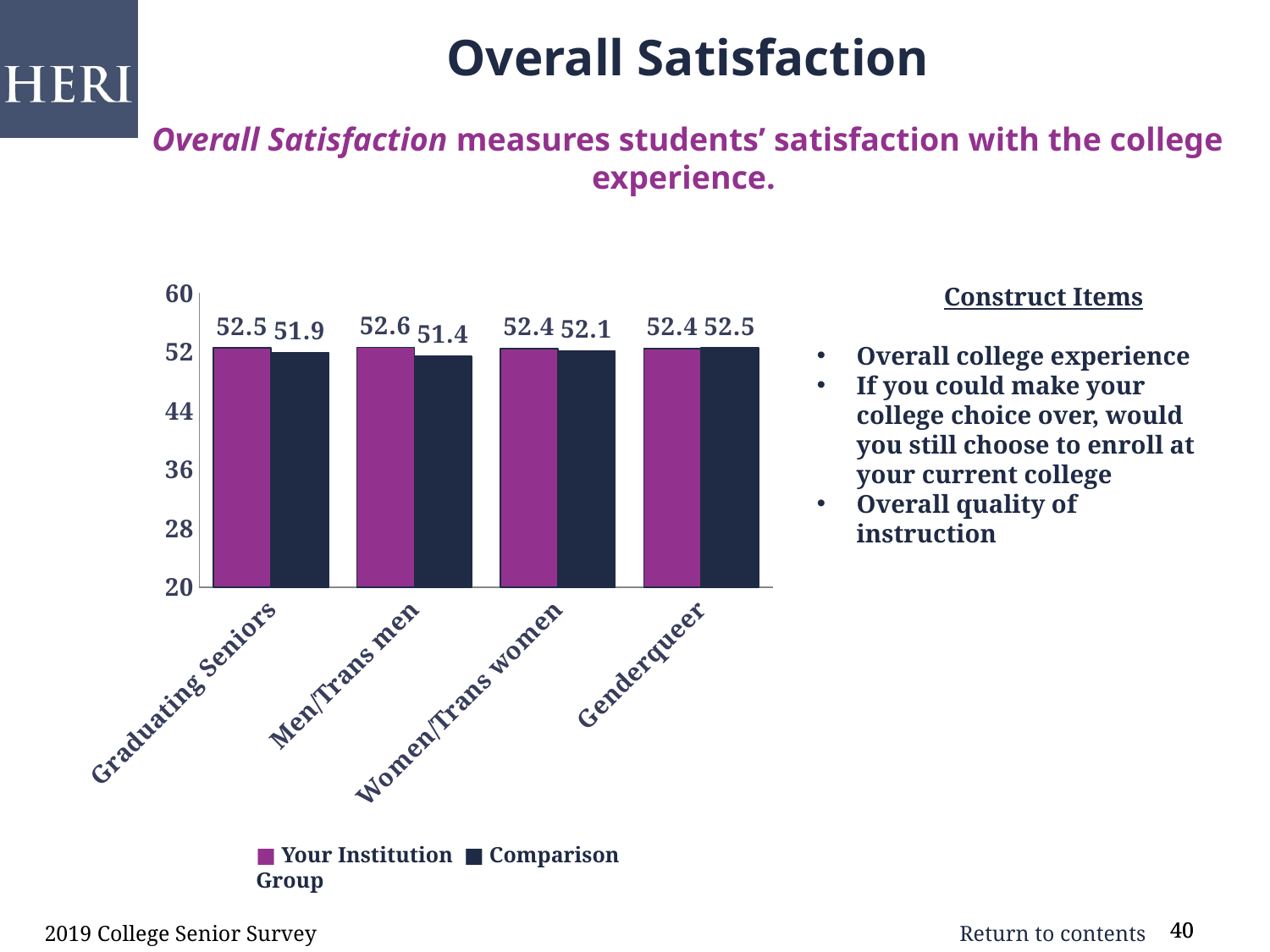
How many series does the legend list? 2 How many categories are shown on the x axis? 4 Which series is shown in purple? Your Institution What is the Comparison Group value for Men/Trans men? 51.4 What is the Your Institution value for Graduating Seniors? 52.5 What is the difference between the Your Institution and Comparison Group values for Men/Trans men? 1.2 What is the Your Institution value for Women/Trans women? 52.4 Which category has the lowest Comparison Group value? Men/Trans men For Genderqueer, which is larger: the Your Institution value or the Comparison Group value? Comparison Group What kind of chart is shown on the slide? Bar chart Which category has the highest Comparison Group value? Genderqueer What is the Comparison Group value for Genderqueer? 52.5